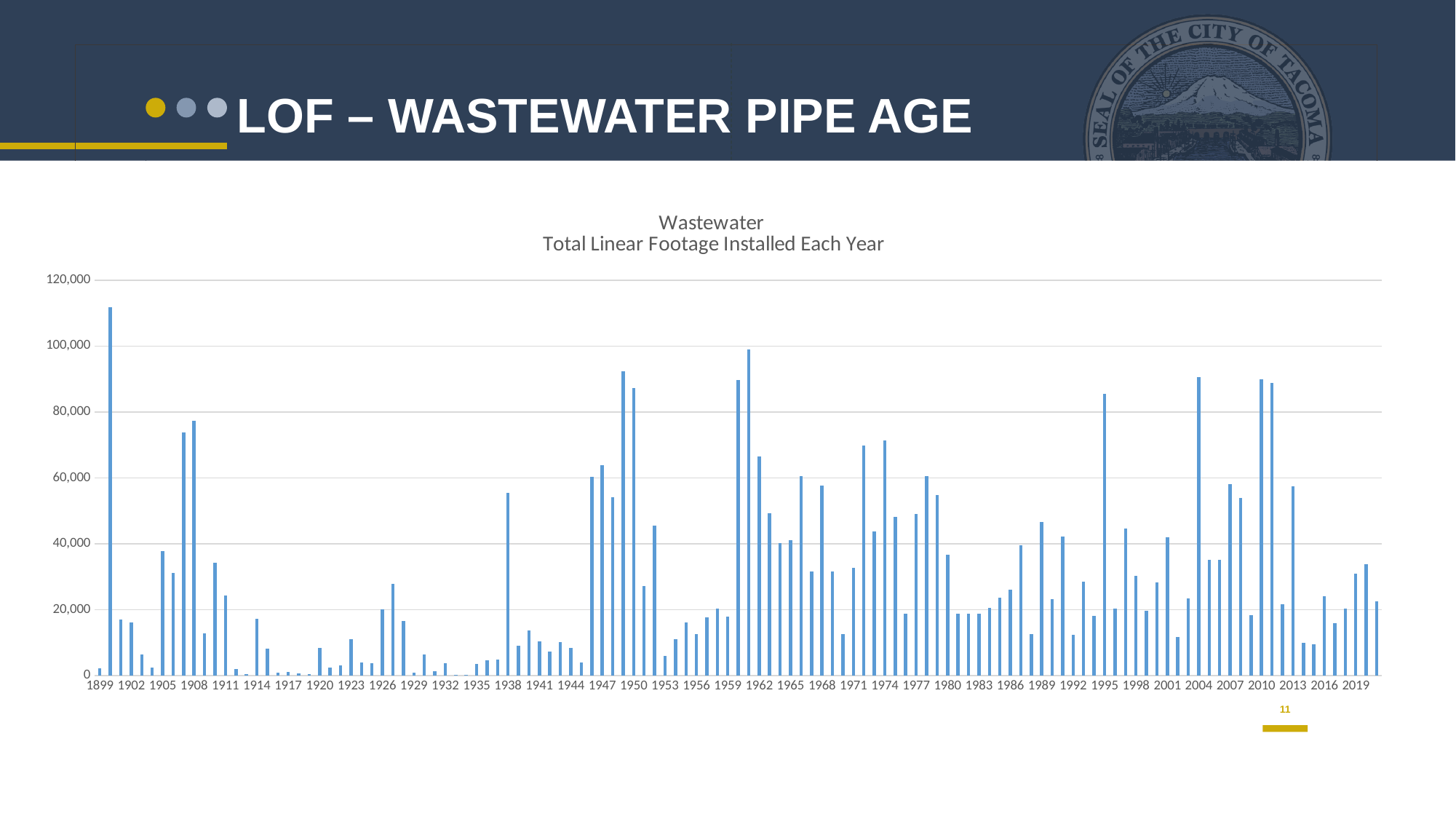
What is the title of the chart? Wastewater Total Linear Footage Installed Each Year Which year has the larger value, 1908 or 1902? 1908 Which year has the larger value, 1950 or 1938? 1950 Is the value for 2004 greater or less than 80,000? greater What is the highest value shown on the vertical axis? 120,000 Is the value for 1938 greater or less than 40,000? greater Is the value for 1908 greater or less than 60,000? greater What kind of chart is shown on the slide? bar chart